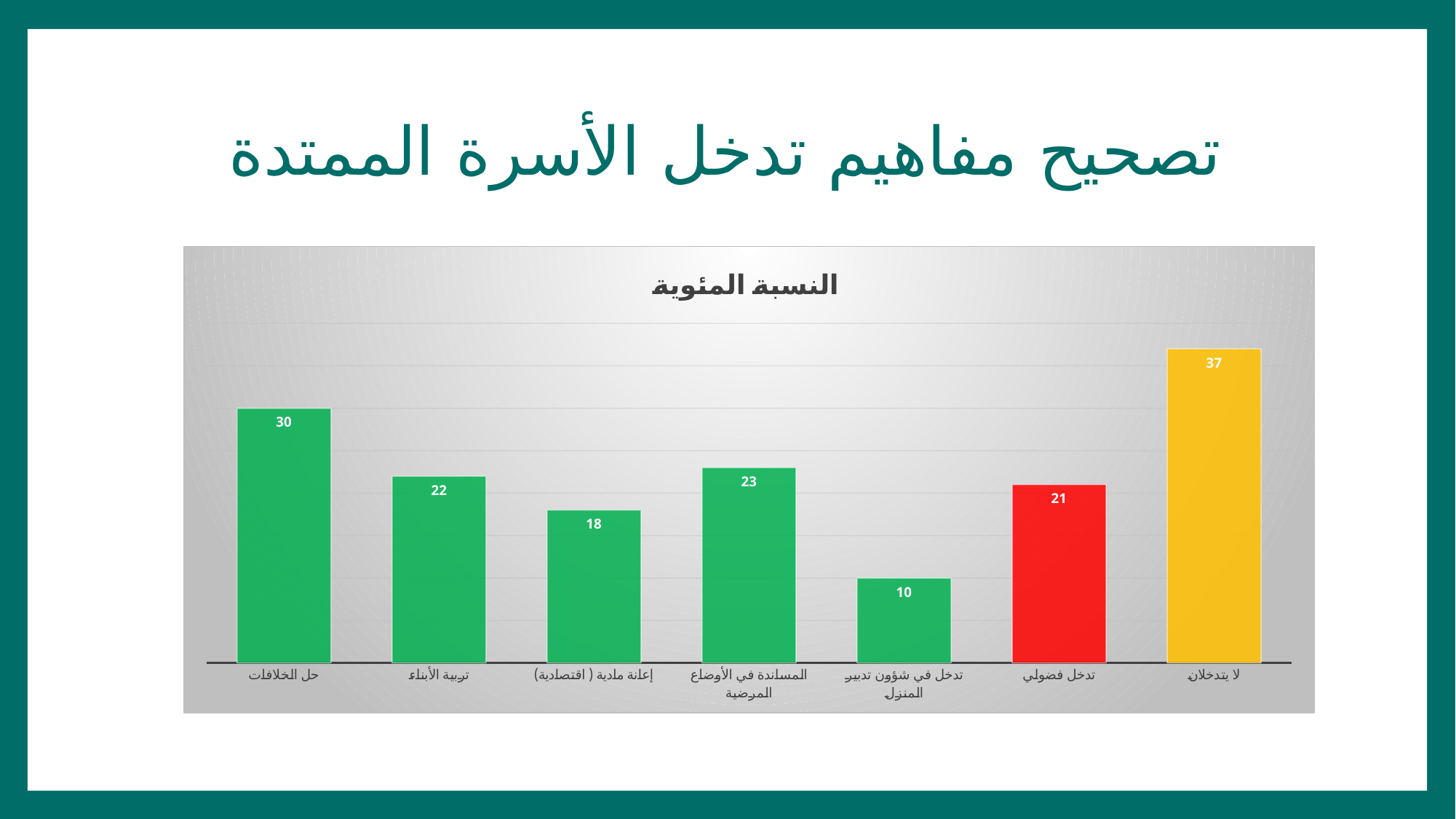
What is the value for إعانة مادية (اقتصادية)? 18 What is the value for تربية الأبناء? 22 What is the value for حل الخلافات? 30 What is the title of the chart? النسبة المئوية What is the value for المساندة في الأوضاع المرضية? 23 Which is larger, the value for تربية الأبناء or the value for تدخل فضولي? تربية الأبناء What is the difference between the values for لا يتدخلان and حل الخلافات? 7 Which category has the lowest value? تدخل في شؤون تدبير المنزل What is the value for تدخل فضولي? 21 What kind of chart is shown on the slide? Bar chart How many categories are shown in the chart? 7 Which category has the highest value? لا يتدخلان